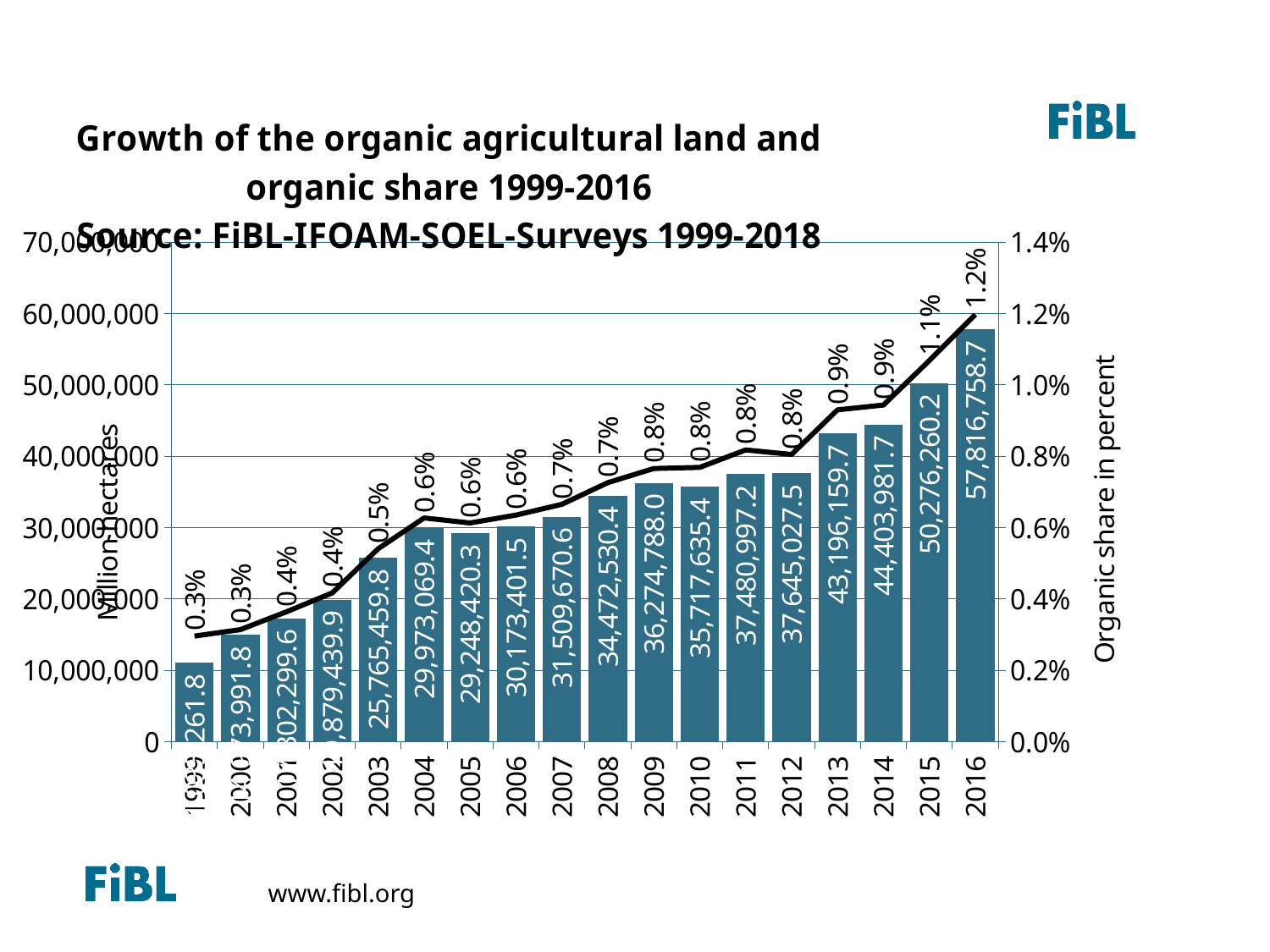
What is the organic agricultural land value shown for 2016? 57,816,758.7 What organic share in percent is shown for 2016? 1.2% How many years are shown on the x axis of the chart? 18 What is the difference in organic agricultural land between 2016 and 2015? 7,540,498.5 Is the organic agricultural land value for 2001 greater or less than 20,000,000? less What organic share in percent is shown for 2003? 0.5% Which year has the lowest organic agricultural land value? 1999 Which year has the highest organic agricultural land value? 2016 What kind of chart is shown on the slide? Combined bar and line chart Does the organic share in percent rise or fall from 1999 to 2016? Rise What is the organic agricultural land value shown for 2008? 34,472,530.4 Which year has the larger organic agricultural land value, 2009 or 2010? 2009